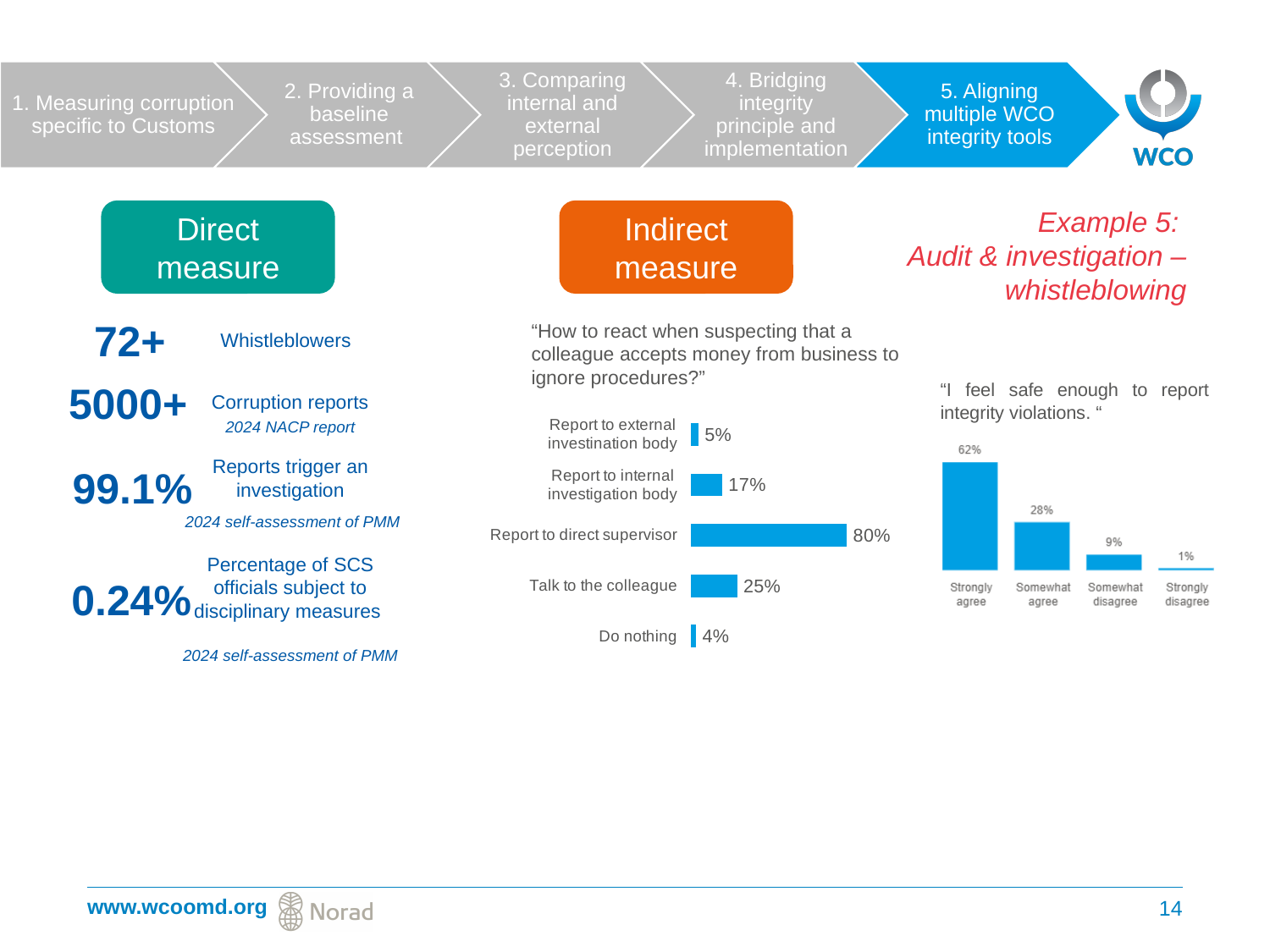
In the chart on the left ("How to react when suspecting that a colleague accepts money..."), what is the value for "Report to direct supervisor"? 80% In the chart on the left ("How to react when suspecting that a colleague accepts money..."), how many categories are shown? 5 In the chart on the right ("I feel safe enough to report integrity violations"), which category has the highest value? Strongly agree In the chart on the left ("How to react when suspecting that a colleague accepts money..."), what is the difference between "Talk to the colleague" and "Report to internal investigation body"? 8% In the chart on the left ("How to react when suspecting that a colleague accepts money..."), what is the value for "Do nothing"? 4% In the chart on the right ("I feel safe enough to report integrity violations"), do the values rise or fall from left to right? Fall In the chart on the left ("How to react when suspecting that a colleague accepts money..."), which category has the lowest value? Do nothing In the chart on the left ("How to react when suspecting that a colleague accepts money..."), which category has the highest value? Report to direct supervisor In the chart on the right ("I feel safe enough to report integrity violations"), what is the value for "Somewhat agree"? 28% In the chart on the right ("I feel safe enough to report integrity violations"), which category has the lowest value? Strongly disagree In the chart on the right ("I feel safe enough to report integrity violations"), what is the difference between "Strongly agree" and "Somewhat agree"? 34% What type of chart is the chart on the left ("How to react when suspecting that a colleague accepts money...")? Bar chart